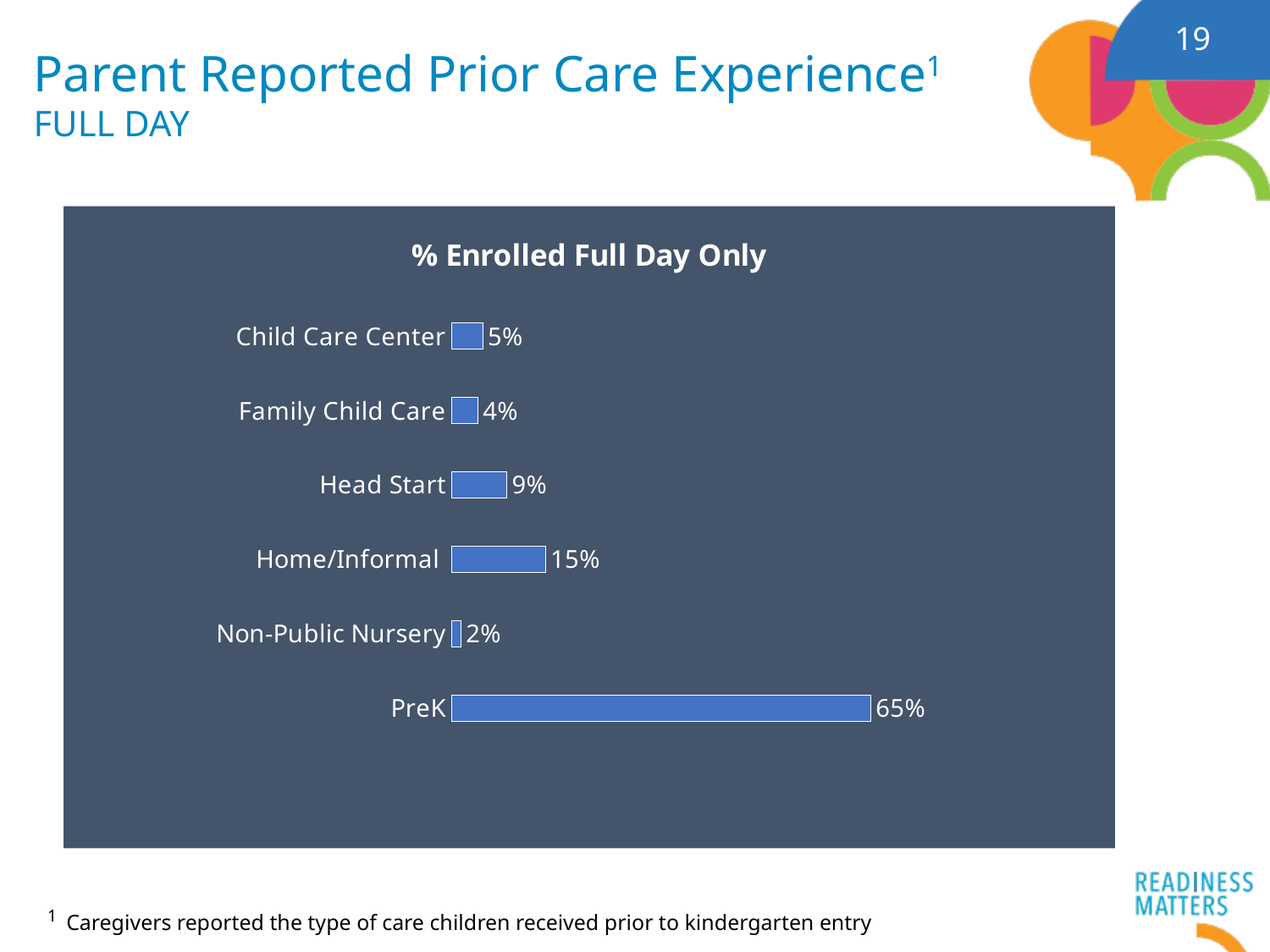
What kind of chart is shown on the slide? Bar chart How many categories are shown in the chart? 6 What is the value for Non-Public Nursery? 2% What is the value for Home/Informal? 15% Which category has the highest value? PreK What is the title of the chart? % Enrolled Full Day Only Which category has the lowest value? Non-Public Nursery Which is larger, the value for Head Start or the value for Home/Informal? Home/Informal What is the difference between the values for Child Care Center and Family Child Care? 1% What is the value for PreK? 65% What is the difference between the values for PreK and Home/Informal? 50% What is the value for Head Start? 9%